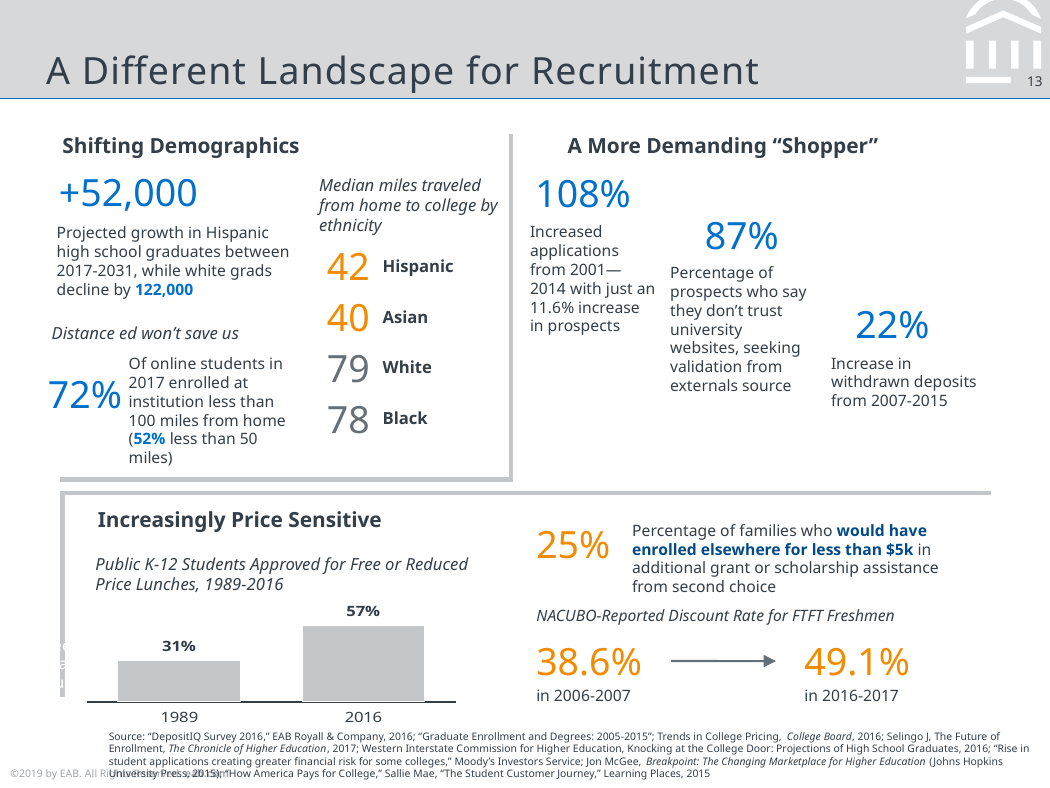
How many bars are shown in the bar chart? 2 What is the value for 1989 in the bar chart? 31% What is the title of the bar chart? Public K-12 Students Approved for Free or Reduced Price Lunches, 1989-2016 Which section of the slide contains the bar chart? Increasingly Price Sensitive What is the value for 2016 in the bar chart? 57% Which year has the higher value in the bar chart? 2016 What kind of chart is shown on the slide? bar chart Do the values in the bar chart rise or fall from 1989 to 2016? rise Which year has the lower value in the bar chart? 1989 What is the difference between the 2016 and 1989 values in the bar chart? 26% Is the value for 2016 larger or smaller than the value for 1989 in the bar chart? larger